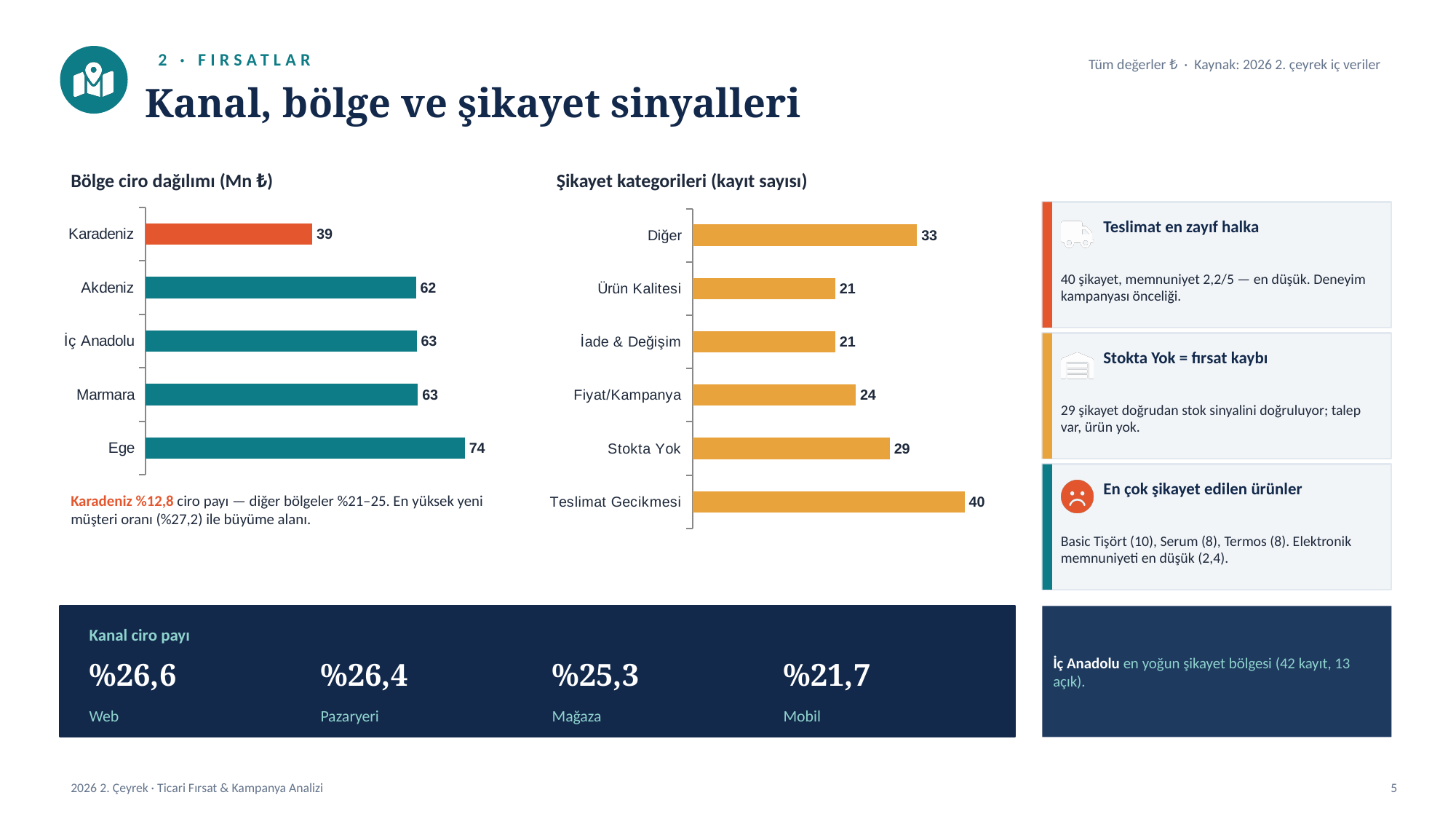
In the 'Bölge ciro dağılımı (Mn ₺)' chart, what is the value for Karadeniz? 39 In the 'Şikayet kategorileri (kayıt sayısı)' chart, which is larger: Diğer or Fiyat/Kampanya? Diğer In the 'Bölge ciro dağılımı (Mn ₺)' chart, how many regions are shown? 5 In the 'Şikayet kategorileri (kayıt sayısı)' chart, how many complaint categories are shown? 6 In the 'Bölge ciro dağılımı (Mn ₺)' chart, which region has the lowest value? Karadeniz In the 'Bölge ciro dağılımı (Mn ₺)' chart, what is the value for Ege? 74 In the 'Şikayet kategorileri (kayıt sayısı)' chart, what is the value for Teslimat Gecikmesi? 40 In the 'Şikayet kategorileri (kayıt sayısı)' chart, what is the value for Stokta Yok? 29 In the 'Bölge ciro dağılımı (Mn ₺)' chart, what is the difference between Ege and Karadeniz? 35 What type of chart is the 'Şikayet kategorileri (kayıt sayısı)' chart? Bar chart In the 'Bölge ciro dağılımı (Mn ₺)' chart, which region has the highest value? Ege In the 'Şikayet kategorileri (kayıt sayısı)' chart, which category has the highest number of records? Teslimat Gecikmesi